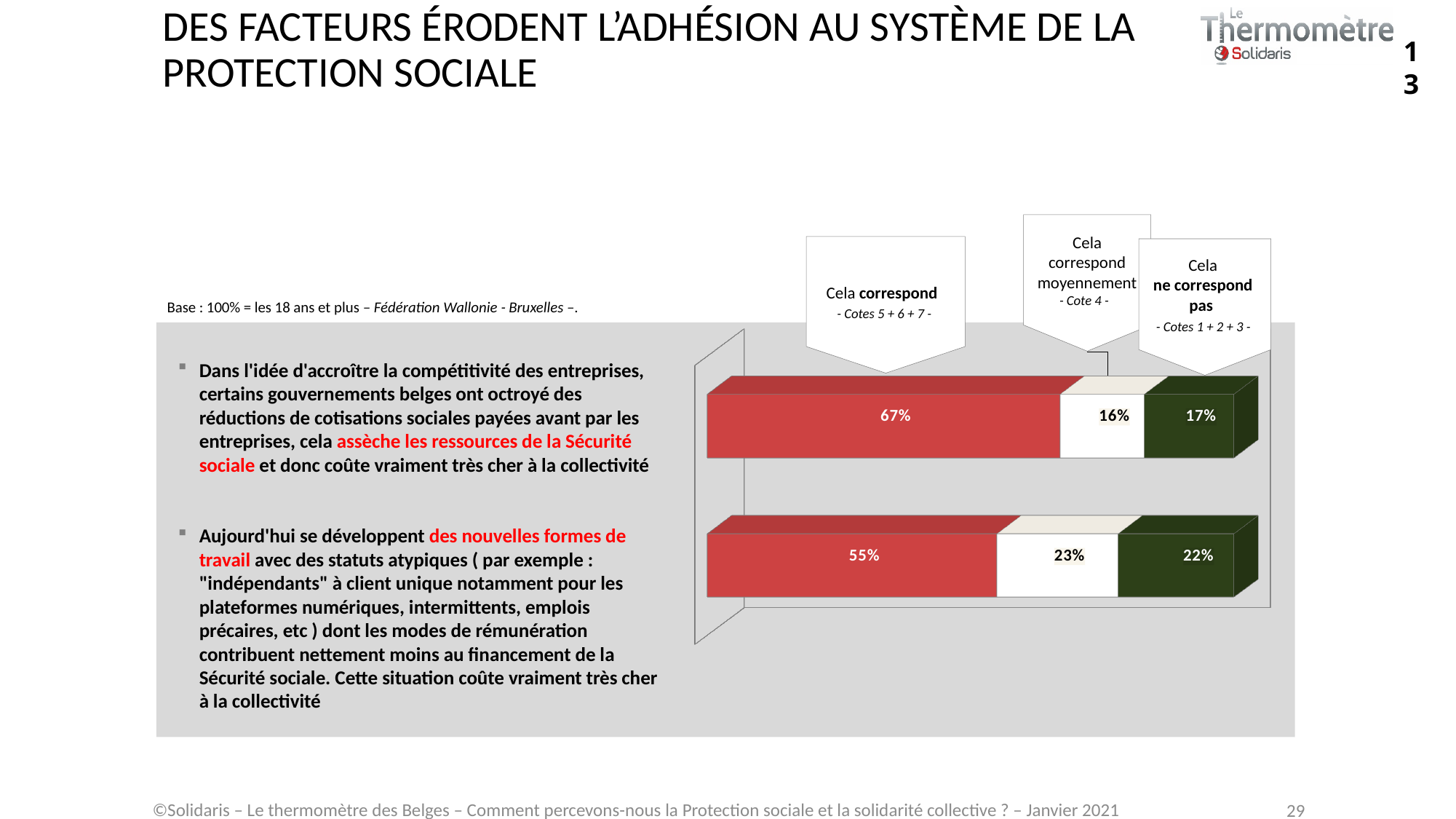
What is the 'Cela correspond' value for the bottom bar (the statement about new forms of work)? 55% What is the 'Cela correspond' value for the top bar (the statement about reductions in social contributions)? 67% How many bars (statements) does the chart show? 2 What is the 'Cela correspond moyennement' value for the top bar (the statement about reductions in social contributions)? 16% What is the 'Cela ne correspond pas' value for the bottom bar (the statement about new forms of work)? 22% What is the difference between the 'Cela correspond moyennement' values of the bottom bar (23%) and the top bar (16%)? 7 percentage points What is the difference between the 'Cela correspond' values of the top bar (67%) and the bottom bar (55%)? 12 percentage points How many response categories (series) are labelled above the chart? 3 What is the total of the three segments in the bottom bar (55%, 23%, 22%)? 100% Which colour represents the 'Cela ne correspond pas' response in the chart? Dark green Which statement has the higher 'Cela correspond' share: the one about reductions in social contributions (top bar) or the one about new forms of work (bottom bar)? The one about reductions in social contributions (top bar) What kind of chart is shown on the slide? Stacked bar chart